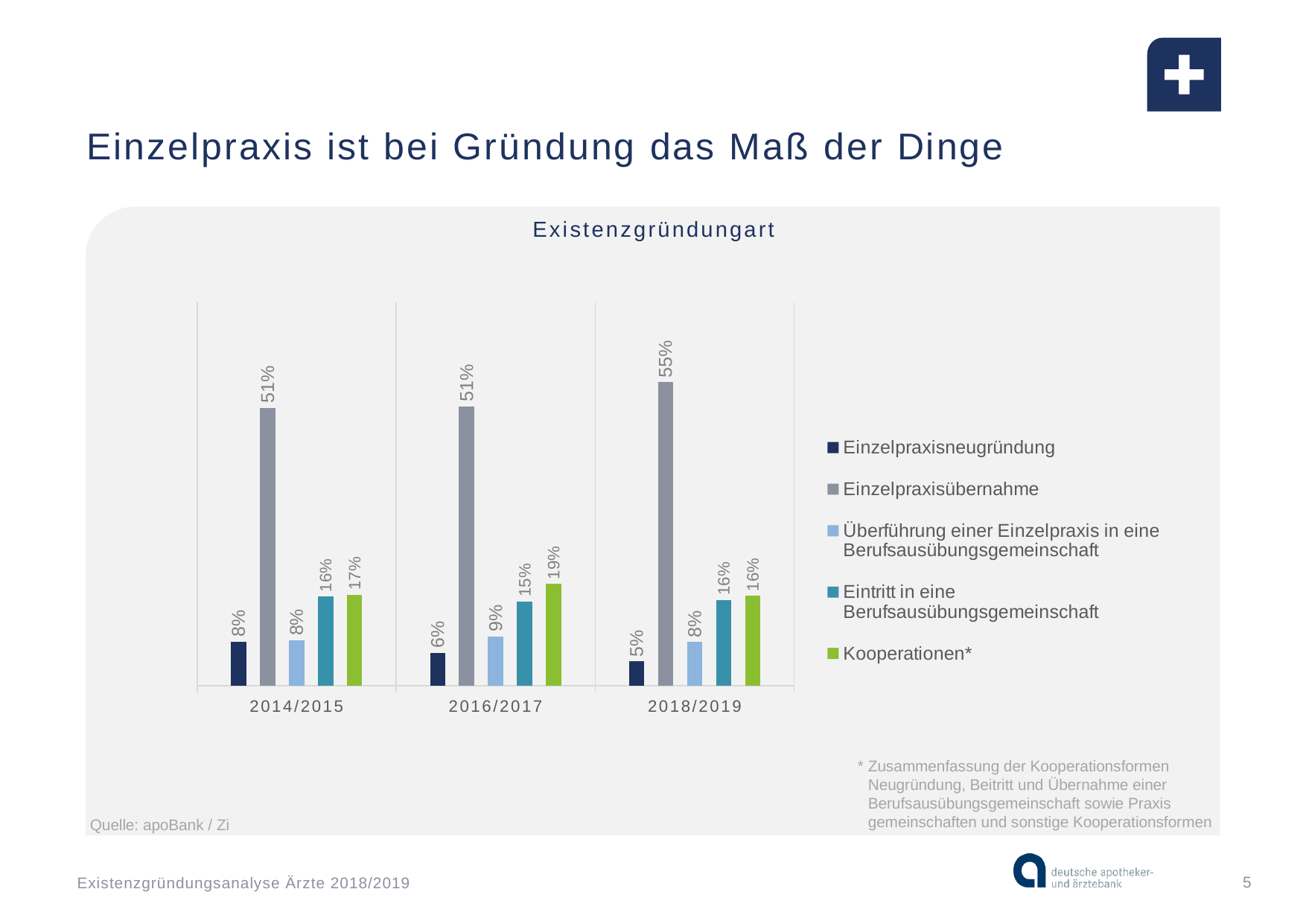
How many periods are shown on the x axis? 3 In which period is Einzelpraxisübernahme highest? 2018/2019 What is the value for Eintritt in eine Berufsausübungsgemeinschaft in 2016/2017? 15% In which period is Einzelpraxisneugründung lowest? 2018/2019 Which is larger in 2014/2015: Kooperationen* or Eintritt in eine Berufsausübungsgemeinschaft? Kooperationen* How many series does the legend list? 5 What is the value for Einzelpraxisneugründung in 2014/2015? 8% What kind of chart is shown? Bar chart Does the value for Einzelpraxisneugründung rise or fall from 2014/2015 to 2018/2019? Fall What is the value for Einzelpraxisübernahme in 2018/2019? 55% What is the value for Kooperationen* in 2016/2017? 19% What is the difference between Einzelpraxisübernahme in 2018/2019 and in 2016/2017? 4%